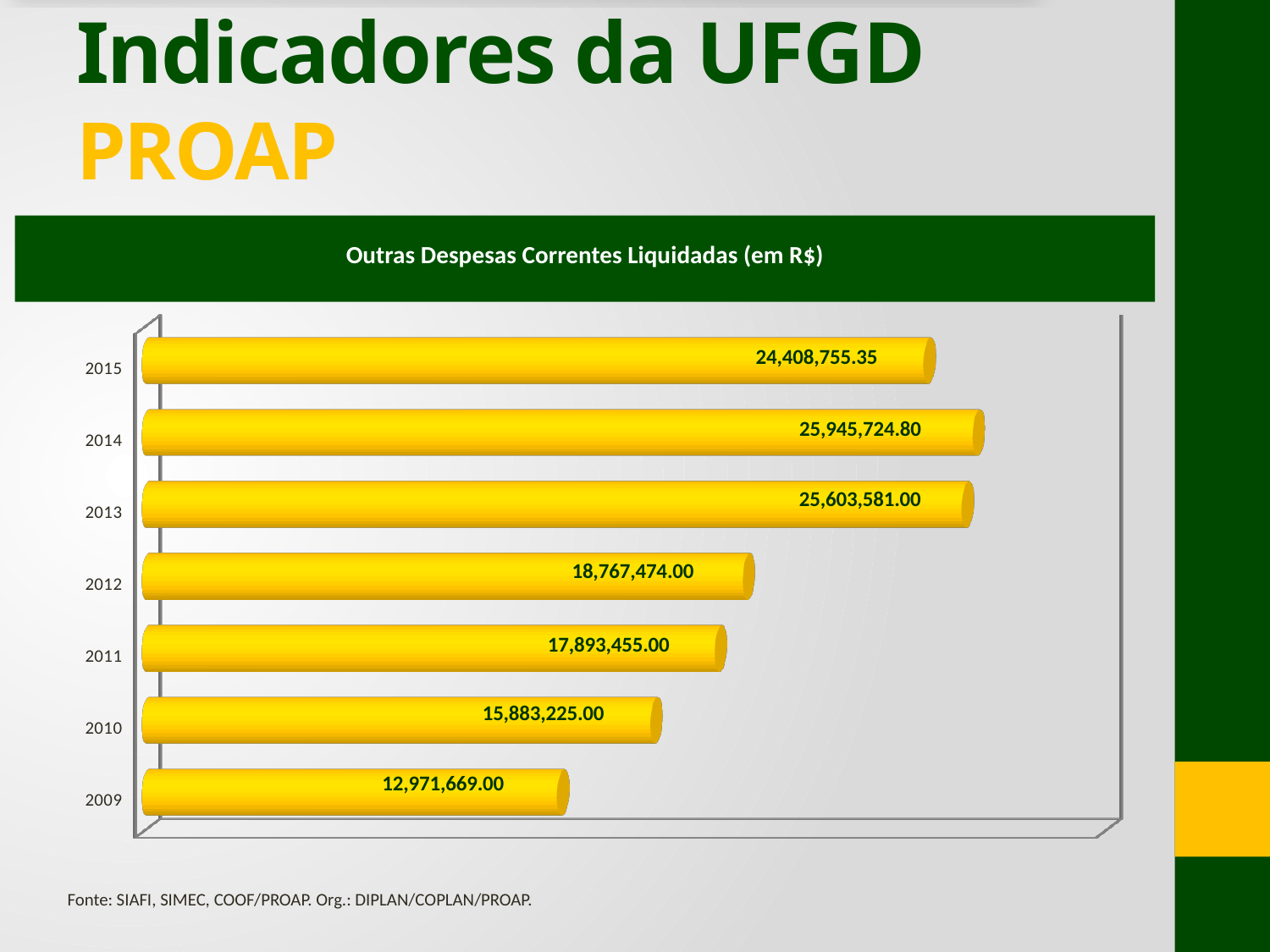
What is the value for 2009 in the chart? 12,971,669.00 What kind of chart is shown on the slide? Bar chart Which year has the highest value in the chart? 2014 Which is larger, the value for 2015 or the value for 2013? 2013 How many years are shown in the chart? 7 What is the difference between the values for 2010 and 2009? 2,911,556.00 Which is larger, the value for 2011 or the value for 2010? 2011 Which year has the lowest value in the chart? 2009 Did the value rise or fall from 2009 to 2014? Rise What is the difference between the values for 2014 and 2013? 342,143.80 What is the value for 2015 in the chart "Outras Despesas Correntes Liquidadas (em R$)"? 24,408,755.35 What is the value for 2012 in the chart? 18,767,474.00